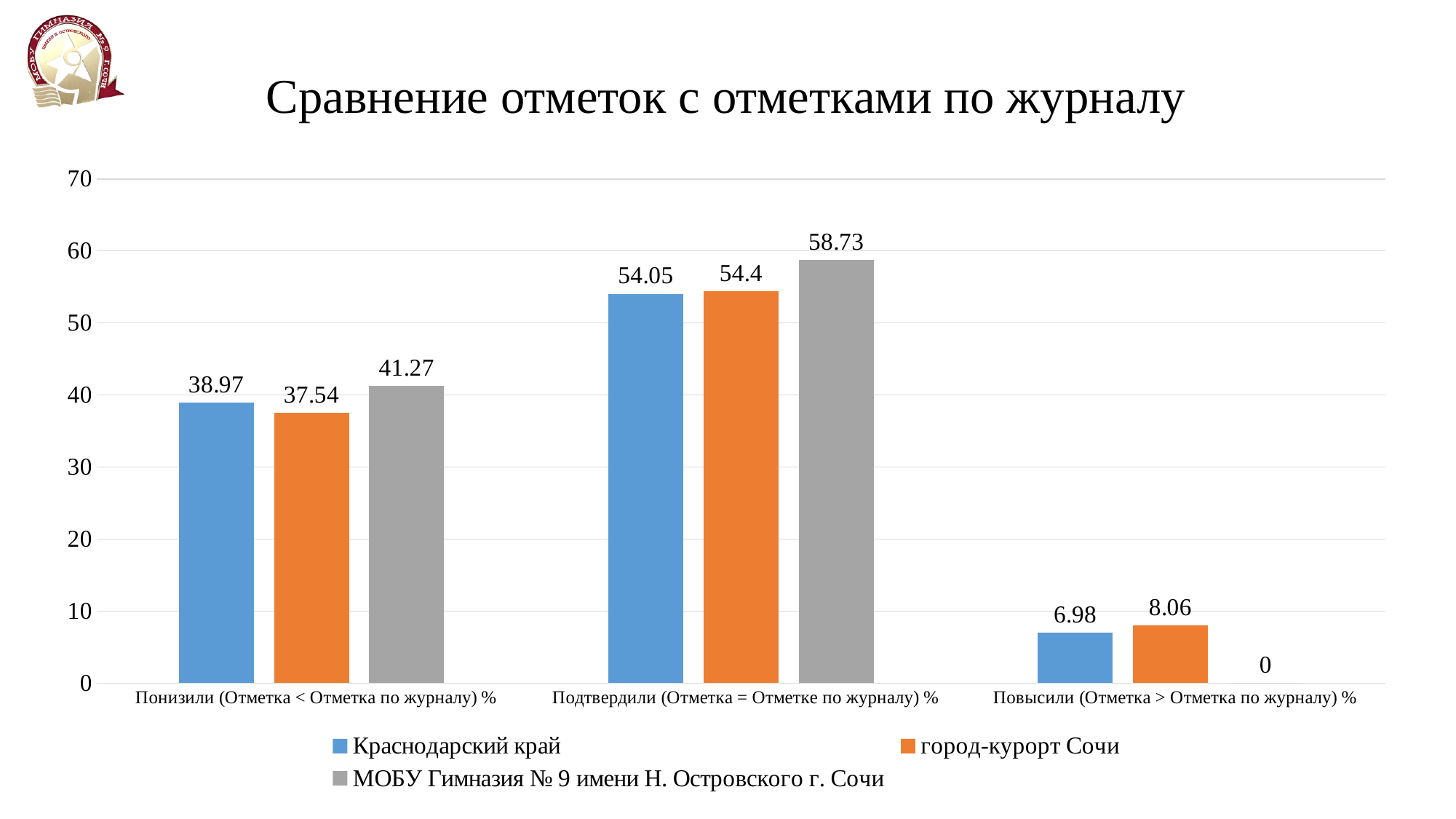
What is the value for МОБУ Гимназия № 9 имени Н. Островского г. Сочи in the category Повысили (Отметка > Отметка по журналу) %? 0 How many categories are shown on the x axis? 3 What is the difference between the values for МОБУ Гимназия № 9 имени Н. Островского г. Сочи and Краснодарский край in the category Подтвердили (Отметка = Отметке по журналу) %? 4.68 Is the value for город-курорт Сочи in the category Понизили (Отметка < Отметка по журналу) % greater or less than 40? less What kind of chart is shown on the slide? bar chart What is the value for МОБУ Гимназия № 9 имени Н. Островского г. Сочи in the category Подтвердили (Отметка = Отметке по журналу) %? 58.73 Which series has the lowest value in the category Понизили (Отметка < Отметка по журналу) %? город-курорт Сочи What is the value for Краснодарский край in the category Понизили (Отметка < Отметка по журналу) %? 38.97 Which series has the highest value in the category Подтвердили (Отметка = Отметке по журналу) %? МОБУ Гимназия № 9 имени Н. Островского г. Сочи What is the value for город-курорт Сочи in the category Повысили (Отметка > Отметка по журналу) %? 8.06 How many series does the legend list? 3 In the category Повысили (Отметка > Отметка по журналу) %, which is larger: Краснодарский край or город-курорт Сочи? город-курорт Сочи